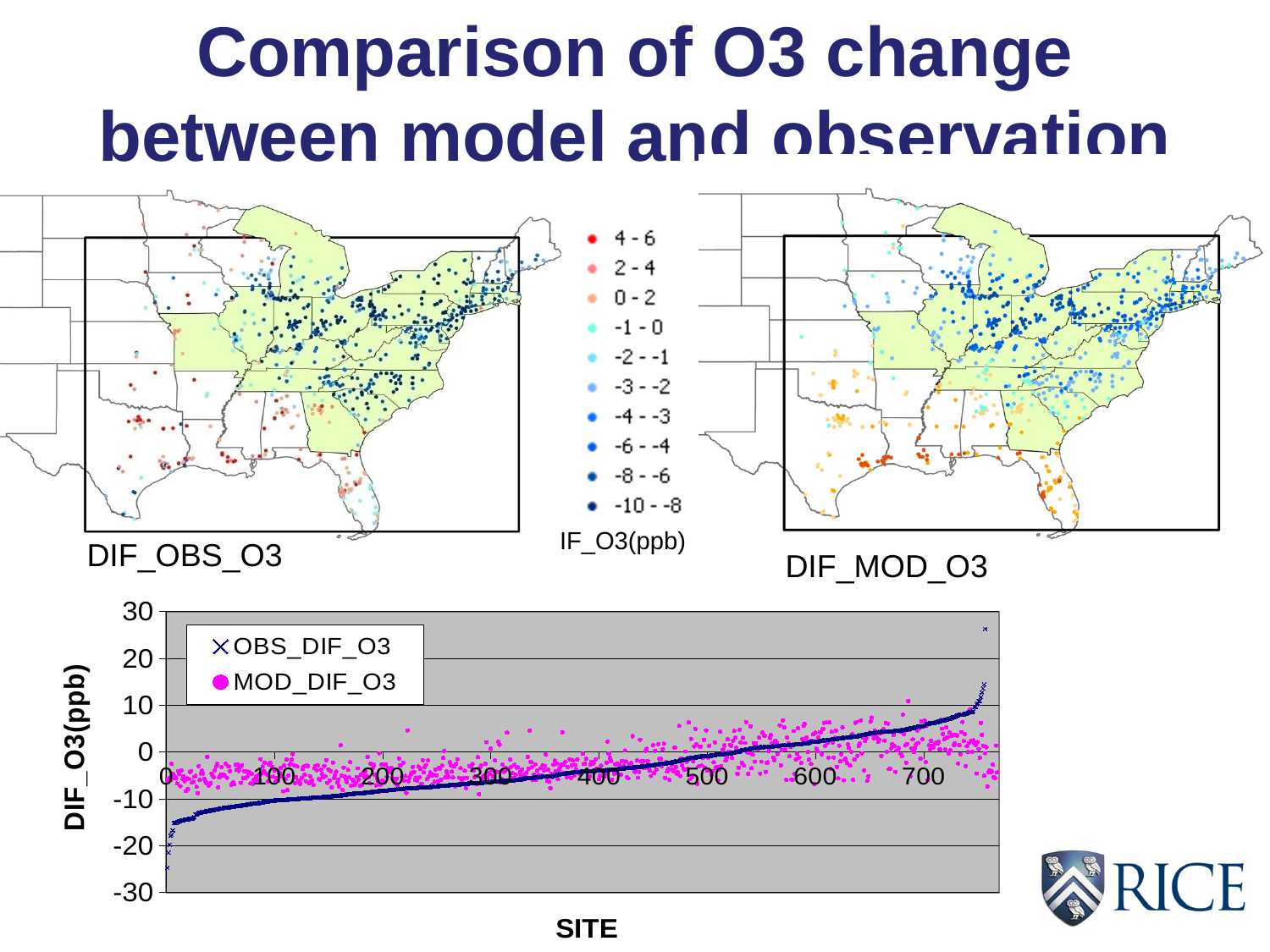
How many series does the legend of the bottom chart list? 2 In the bottom chart, do the OBS_DIF_O3 values rise or fall as SITE increases along the x axis? rise In the bottom chart, which series is plotted with magenta dots? MOD_DIF_O3 In the bottom chart, is the OBS_DIF_O3 value at SITE 400 greater or less than 0? less In the bottom chart, is the OBS_DIF_O3 value at SITE 700 greater or less than 0? greater What kind of chart is the bottom chart with the SITE x axis? scatter chart What is the y-axis title of the bottom chart? DIF_O3(ppb) In the bottom chart, is the OBS_DIF_O3 value at SITE 0 greater or less than -10? less What is the highest value shown on the y axis of the bottom chart? 30 What is the label of the map on the right? DIF_MOD_O3 How many value classes does the colour legend between the two maps list? 10 What is the lowest value shown on the y axis of the bottom chart? -30